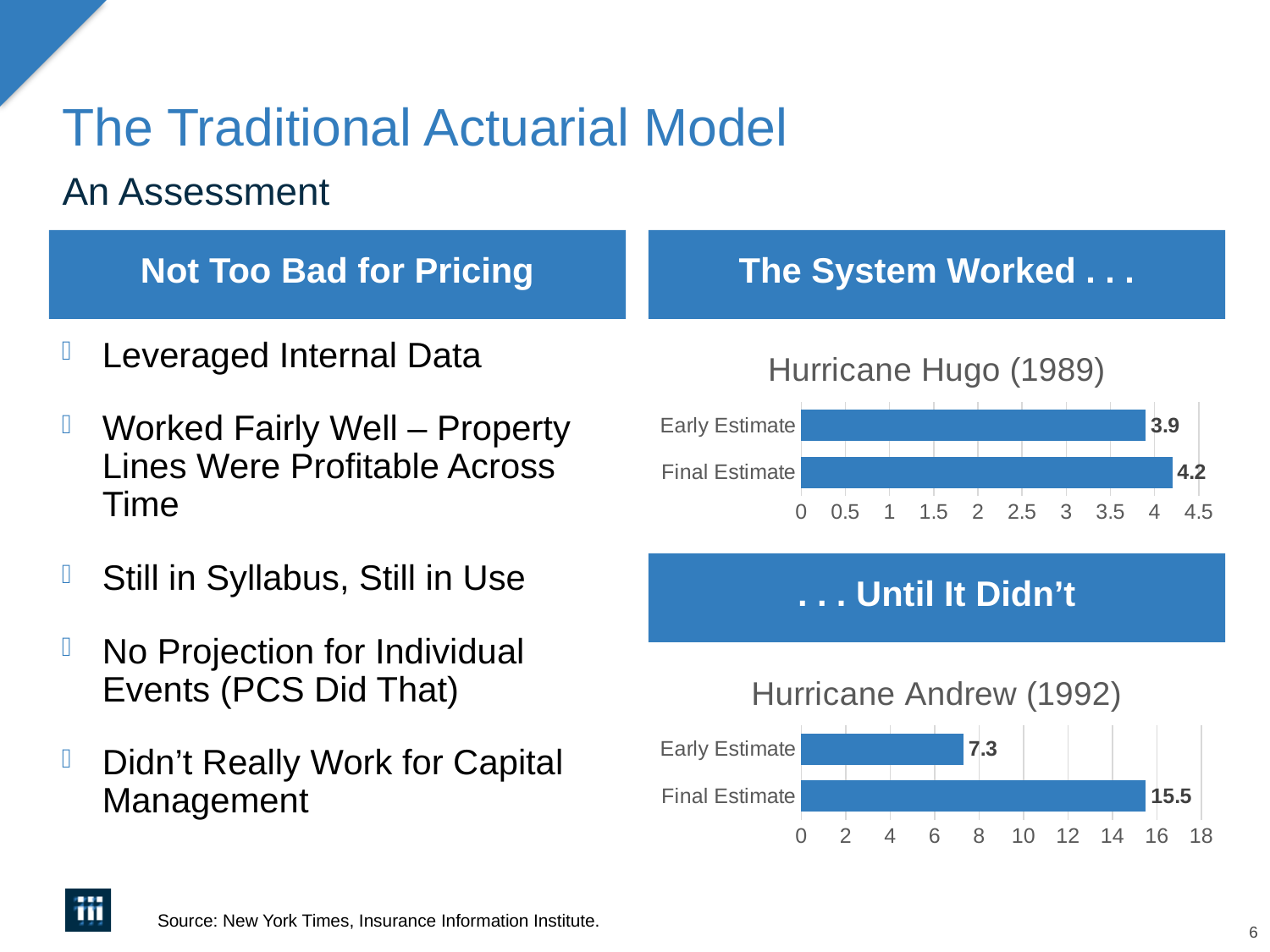
In the Hurricane Andrew (1992) chart, what is the value for Final Estimate? 15.5 What kind of chart is the Hurricane Andrew (1992) chart? Bar chart In the Hurricane Andrew (1992) chart, what is the difference between the Final Estimate and the Early Estimate? 8.2 How many categories are shown in the Hurricane Hugo (1989) chart? 2 In the Hurricane Hugo (1989) chart, what is the value for Final Estimate? 4.2 In the Hurricane Hugo (1989) chart, what is the value for Early Estimate? 3.9 In the Hurricane Andrew (1992) chart, what is the value for Early Estimate? 7.3 In the Hurricane Andrew (1992) chart, which category has the highest value? Final Estimate In the Hurricane Andrew (1992) chart, which is larger, the Early Estimate or the Final Estimate? Final Estimate In the Hurricane Hugo (1989) chart, what is the difference between the Final Estimate and the Early Estimate? 0.3 In the Hurricane Andrew (1992) chart, is the value for Early Estimate greater or less than 8? less In the Hurricane Hugo (1989) chart, which category has the lowest value? Early Estimate